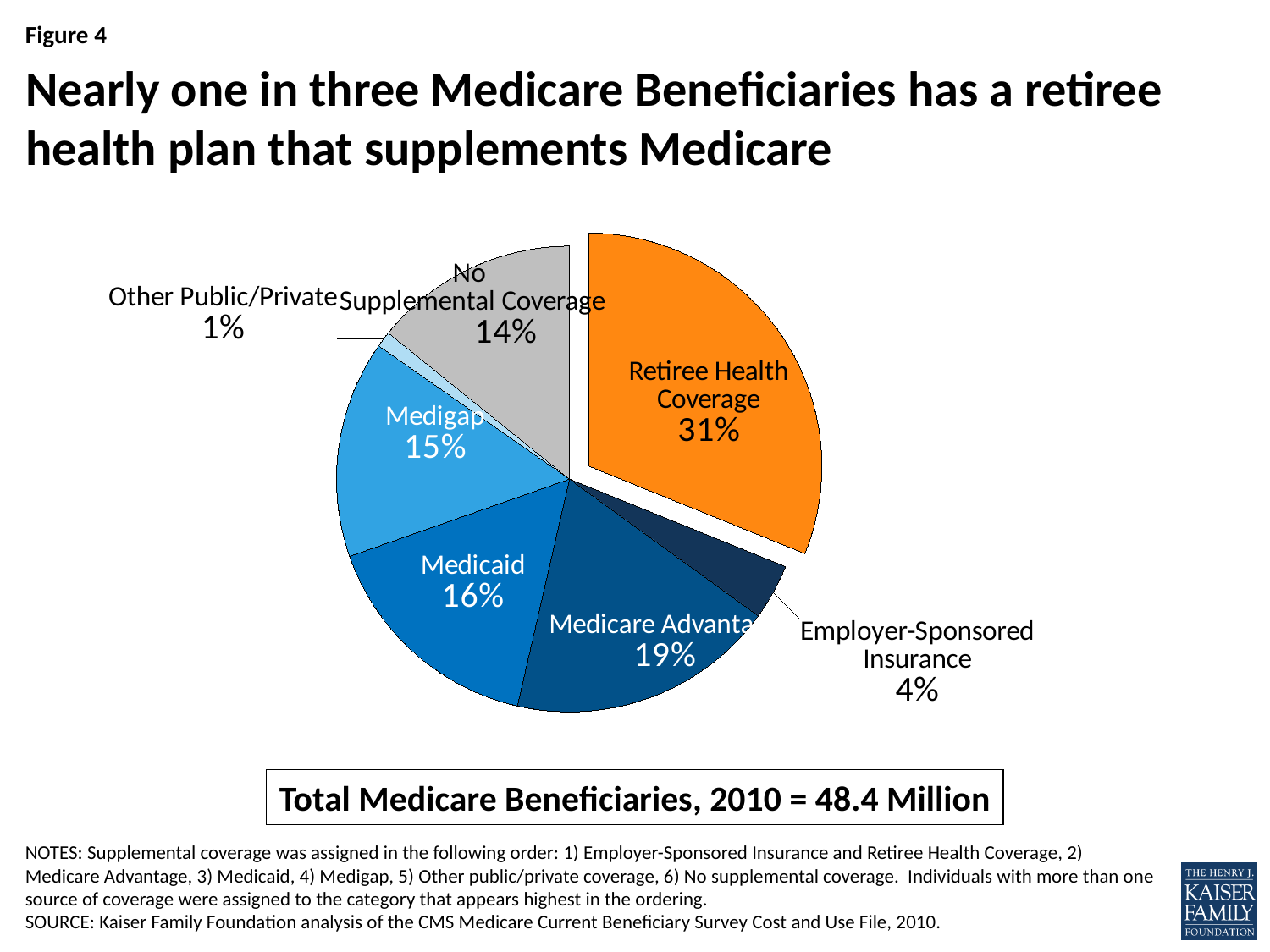
What share of Medicare beneficiaries has Retiree Health Coverage? 31% Which category has the smallest slice of the pie? Other Public/Private What kind of chart is shown on the slide? Pie chart Which category has the largest slice of the pie? Retiree Health Coverage What is the difference in percentage points between Retiree Health Coverage and Medicare Advantage? 12 What share of Medicare beneficiaries has Employer-Sponsored Insurance? 4% Which is larger, the share for Medicaid or the share for Medigap? Medicaid What share of Medicare beneficiaries has Medigap? 15% How many categories are shown in the pie chart? 7 What share of Medicare beneficiaries has Medicaid? 16% What share of Medicare beneficiaries has No Supplemental Coverage? 14% What share of Medicare beneficiaries has Medicare Advantage? 19%